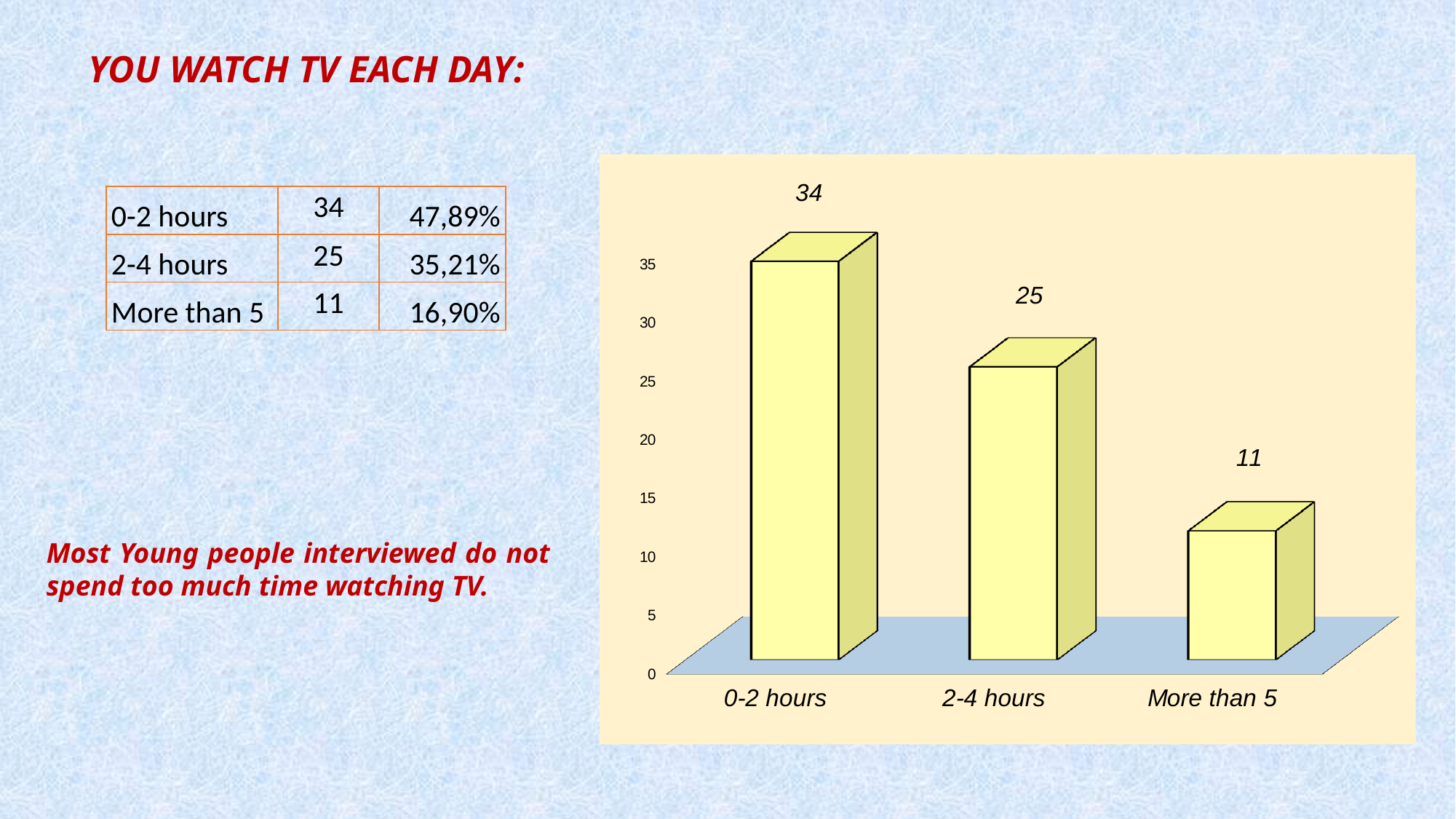
Do the values rise or fall from left to right along the x axis? fall What is the difference between the values for 2-4 hours and More than 5? 14 How many categories are shown on the x axis? 3 What is the difference between the values for 0-2 hours and 2-4 hours? 9 What is the value for More than 5? 11 Which is larger, the value for 2-4 hours or the value for More than 5? 2-4 hours What kind of chart is shown? bar chart What is the value for 2-4 hours? 25 Which category has the highest value? 0-2 hours Which category has the lowest value? More than 5 Is the value for 0-2 hours greater or less than 30? greater What is the value for 0-2 hours? 34